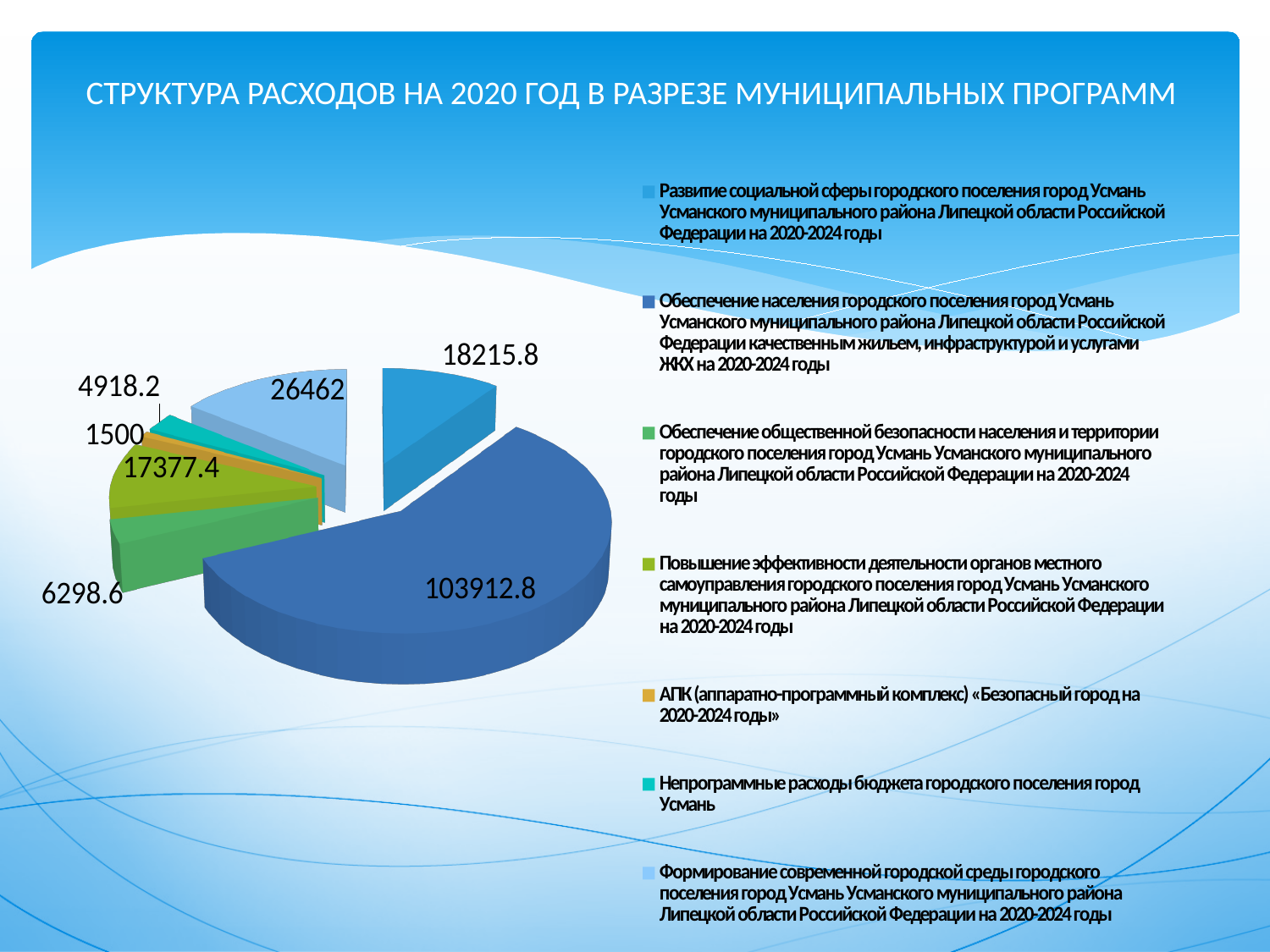
Which program has the largest slice of the pie? Обеспечение населения городского поселения город Усмань ... качественным жильем, инфраструктурой и услугами ЖКХ на 2020-2024 годы How many slices does the pie chart have? 7 What is the title of the slide? СТРУКТУРА РАСХОДОВ НА 2020 ГОД В РАЗРЕЗЕ МУНИЦИПАЛЬНЫХ ПРОГРАММ What is the difference between the slice labelled 26462 and the slice labelled 18215.8? 8246.2 Which is larger: the slice for «Повышение эффективности деятельности органов местного самоуправления ...» (17377.4) or the slice for «Обеспечение общественной безопасности ...» (6298.6)? Повышение эффективности деятельности органов местного самоуправления ... What is the value of the slice for «Непрограммные расходы бюджета городского поселения город Усмань»? 4918.2 What is the value of the slice for «Обеспечение населения городского поселения город Усмань ... качественным жильем, инфраструктурой и услугами ЖКХ на 2020-2024 годы»? 103912.8 What is the value of the slice for «Развитие социальной сферы городского поселения город Усмань ... на 2020-2024 годы»? 18215.8 What is the value of the slice for «Формирование современной городской среды городского поселения город Усмань ... на 2020-2024 годы»? 26462 What type of chart is shown on the slide? pie chart Which program has the smallest slice of the pie? АПК (аппаратно-программный комплекс) «Безопасный город на 2020-2024 годы» What is the value of the slice for «АПК (аппаратно-программный комплекс) «Безопасный город на 2020-2024 годы»»? 1500